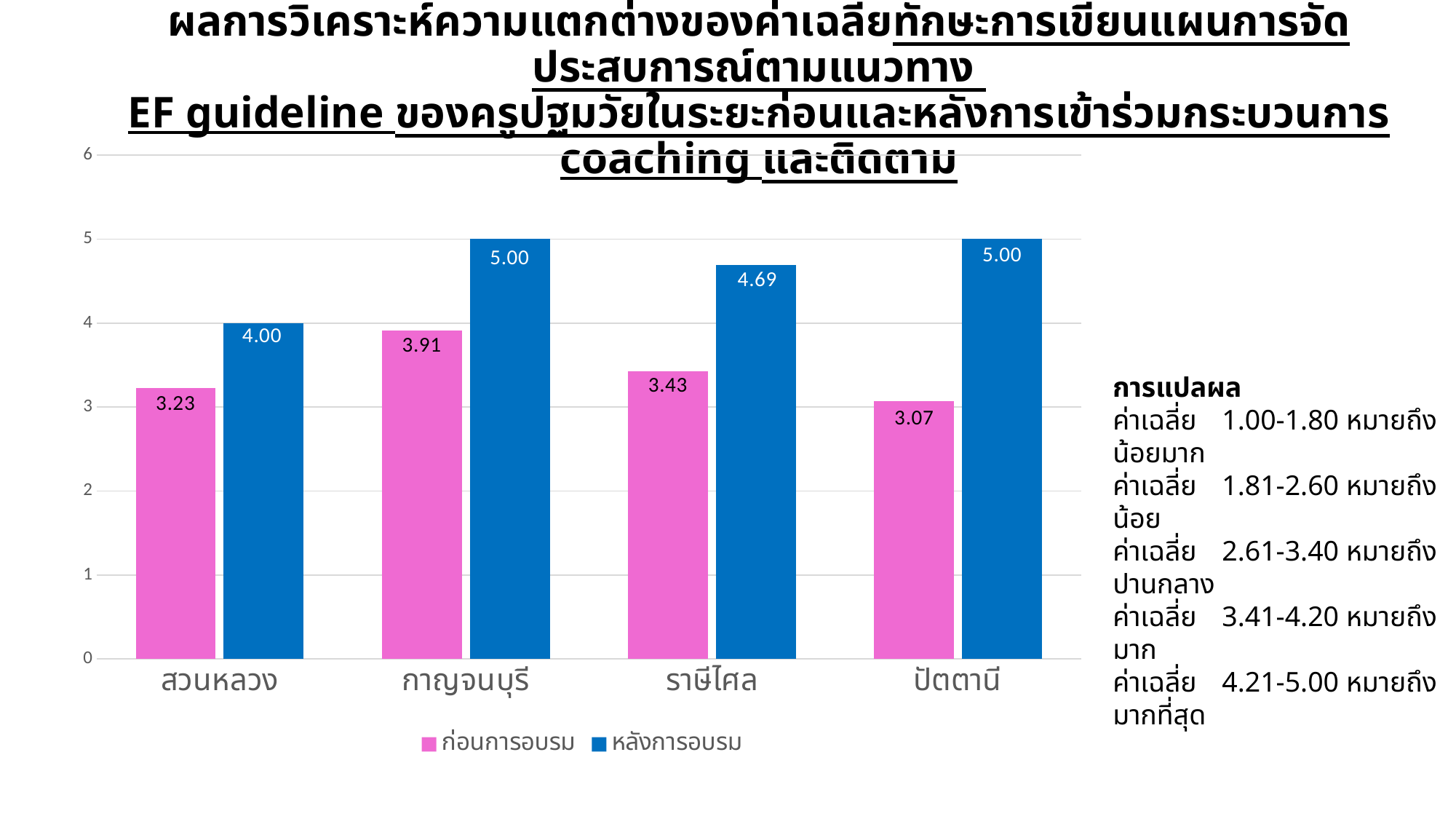
Which category has the highest ก่อนการอบรม value? กาญจนบุรี What is the difference between หลังการอบรม and ก่อนการอบรม at ปัตตานี? 1.93 What is the value for ก่อนการอบรม at สวนหลวง? 3.23 How many series does the legend list? 2 What is the value for หลังการอบรม at ราษีไศล? 4.69 Which category has the lowest ก่อนการอบรม value? ปัตตานี How many categories are shown on the x axis? 4 What is the difference between หลังการอบรม and ก่อนการอบรม at กาญจนบุรี? 1.09 What kind of chart is shown on the slide? bar chart What is the value for ก่อนการอบรม at ปัตตานี? 3.07 Which category has the lowest หลังการอบรม value? สวนหลวง Which is larger: ก่อนการอบรม at ราษีไศล or ก่อนการอบรม at สวนหลวง? ราษีไศล